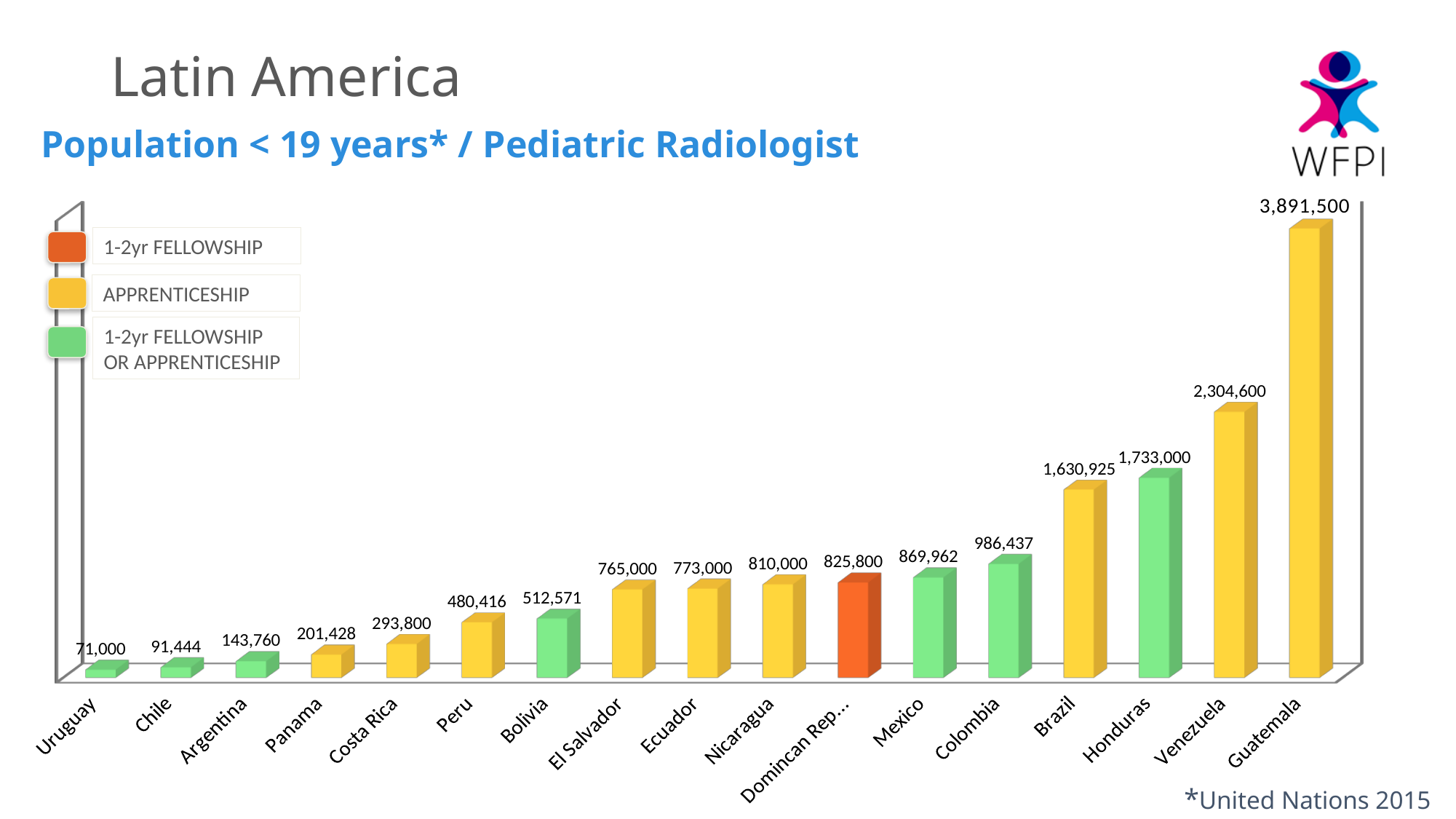
What kind of chart is shown on the slide? Bar chart What is the value shown for Guatemala? 3,891,500 How many countries are shown on the chart? 17 Which country has the highest value on the chart? Guatemala Which country has the lowest value on the chart? Uruguay What is the difference between the values for Guatemala and Venezuela? 1,586,900 What is the difference between the values for Honduras and Brazil? 102,075 What is the value shown for Colombia? 986,437 Which has a larger value, Brazil or Venezuela? Venezuela What is the value shown for Peru? 480,416 Which country's bar is shown in the orange colour for 1-2yr FELLOWSHIP? Domincan Rep... How many entries does the legend list? 3